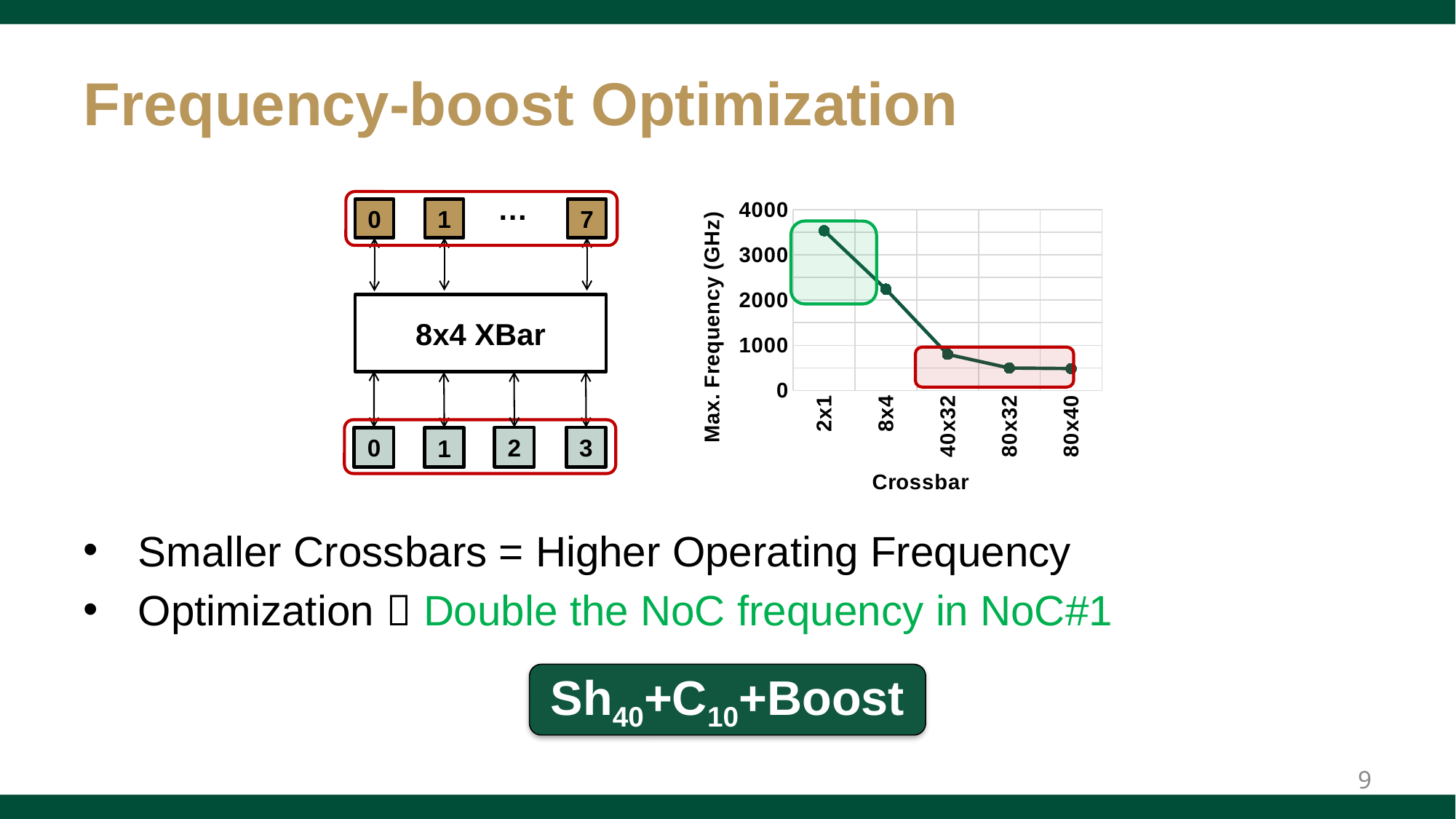
Does the maximum frequency rise or fall as you move from 2x1 to 80x40 along the x axis? fall What is the label of the y axis of the chart? Max. Frequency (GHz) What kind of chart is shown on the slide? line chart Which crossbar has the highest maximum frequency? 2x1 Is the maximum frequency for the 80x32 crossbar greater or less than 1000? less How many crossbar categories are plotted along the x axis? 5 Is the maximum frequency for the 40x32 crossbar greater or less than 1000? less Is the maximum frequency for the 8x4 crossbar greater or less than 2000? greater Which has a higher maximum frequency, the 2x1 crossbar or the 8x4 crossbar? 2x1 What is the label of the x axis of the chart? Crossbar Which has a higher maximum frequency, the 8x4 crossbar or the 40x32 crossbar? 8x4